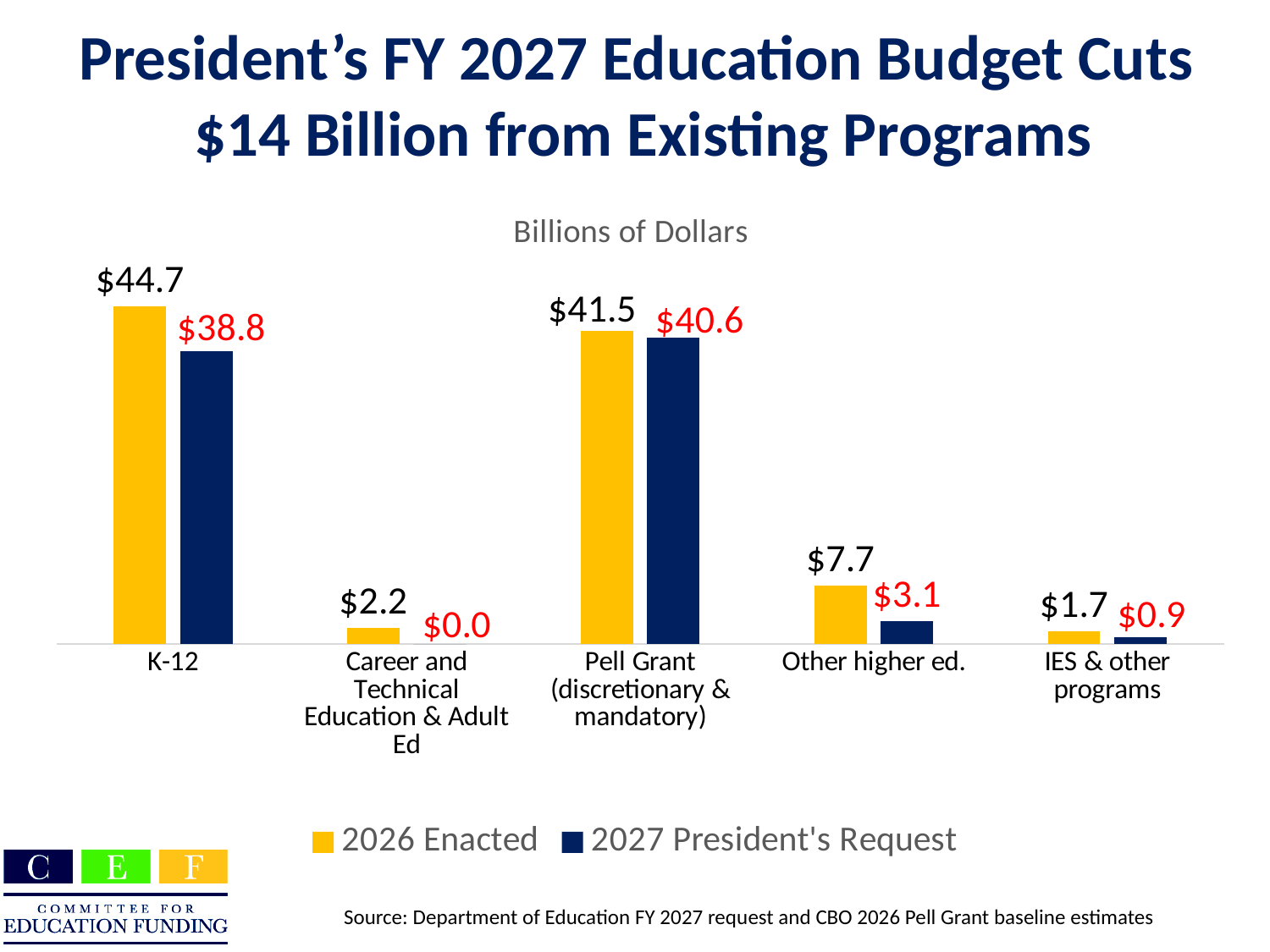
Which category has the lowest 2027 President's Request value? Career and Technical Education & Adult Ed Which is larger: the 2027 President's Request for Pell Grant (discretionary & mandatory) or for K-12? Pell Grant (discretionary & mandatory) What is the difference between the 2026 Enacted and 2027 President's Request values for K-12? $5.9 What is the 2027 President's Request value for Other higher ed.? $3.1 What is the 2026 Enacted value for K-12? $44.7 How many categories are shown on the x axis? 5 What is the difference between the 2026 Enacted and 2027 President's Request values for Other higher ed.? $4.6 What is the 2027 President's Request value for Career and Technical Education & Adult Ed? $0.0 What kind of chart is shown on the slide? Bar chart How many series does the legend list? 2 Which category has the highest 2026 Enacted value? K-12 What unit is stated in the chart's subtitle? Billions of Dollars